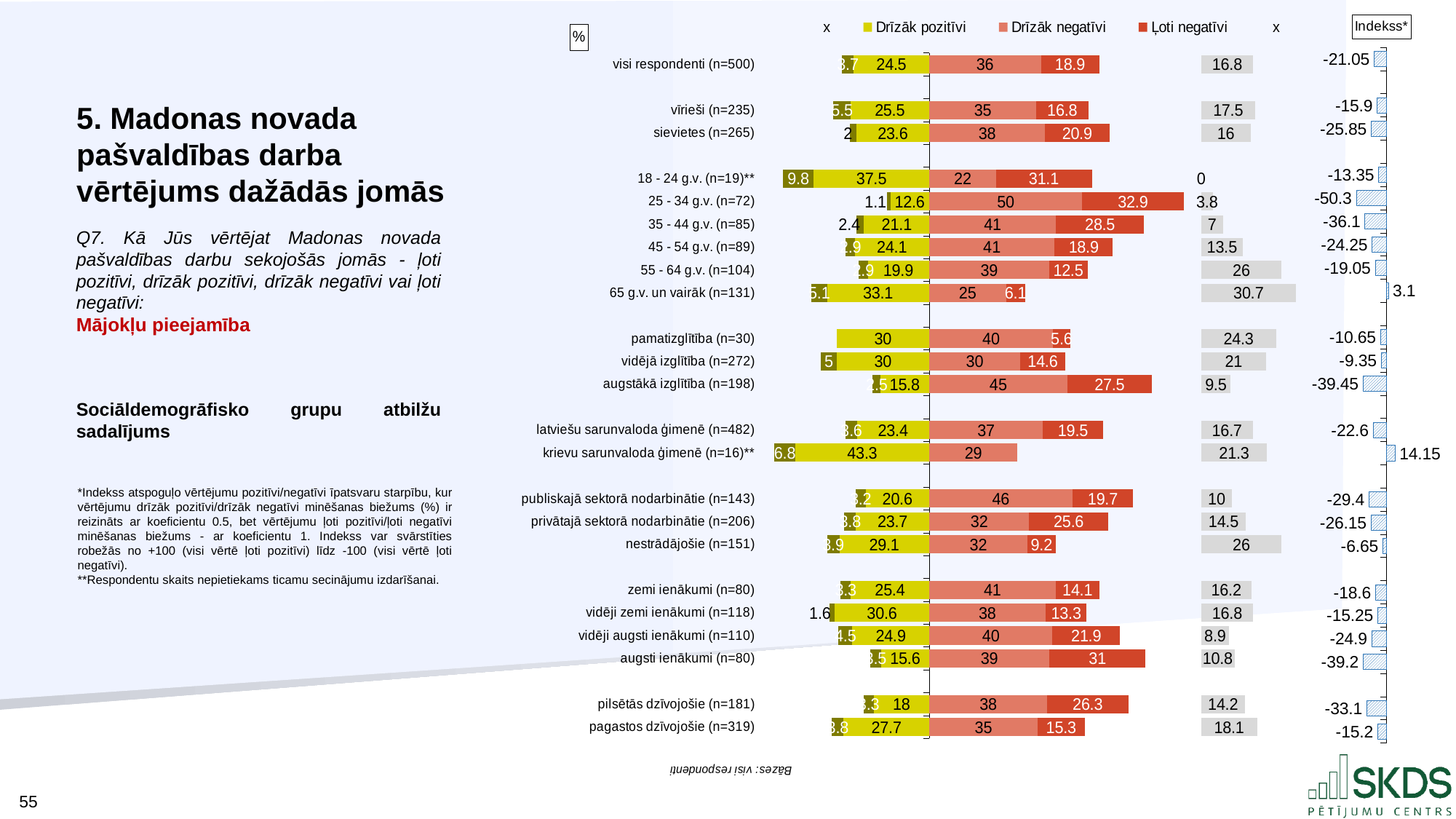
What is the difference between the 'Ļoti negatīvi' values for 'sievietes (n=265)' and 'vīrieši (n=235)'? 4.1 What is the 'Drīzāk negatīvi' value for '25 - 34 g.v. (n=72)'? 50 Which group has the lowest index (Indekss*) value? 25 - 34 g.v. (n=72) What is the 'Drīzāk pozitīvi' value for 'visi respondenti (n=500)'? 24.5 What is the 'Ļoti negatīvi' value for 'augsti ienākumi (n=80)'? 31 How many respondent groups (categories) are plotted in the chart? 23 What kind of chart is shown on the slide? bar chart What is the index (Indekss*) value for 'visi respondenti (n=500)'? -21.05 What is the index (Indekss*) value for 'pilsētās dzīvojošie (n=181)'? -33.1 Which has the larger 'Drīzāk negatīvi' value, 'vīrieši (n=235)' or 'sievietes (n=265)'? sievietes (n=265) Which group has the highest 'Drīzāk pozitīvi' value? krievu sarunvaloda ģimenē (n=16)** Which group has the highest index (Indekss*) value? krievu sarunvaloda ģimenē (n=16)**